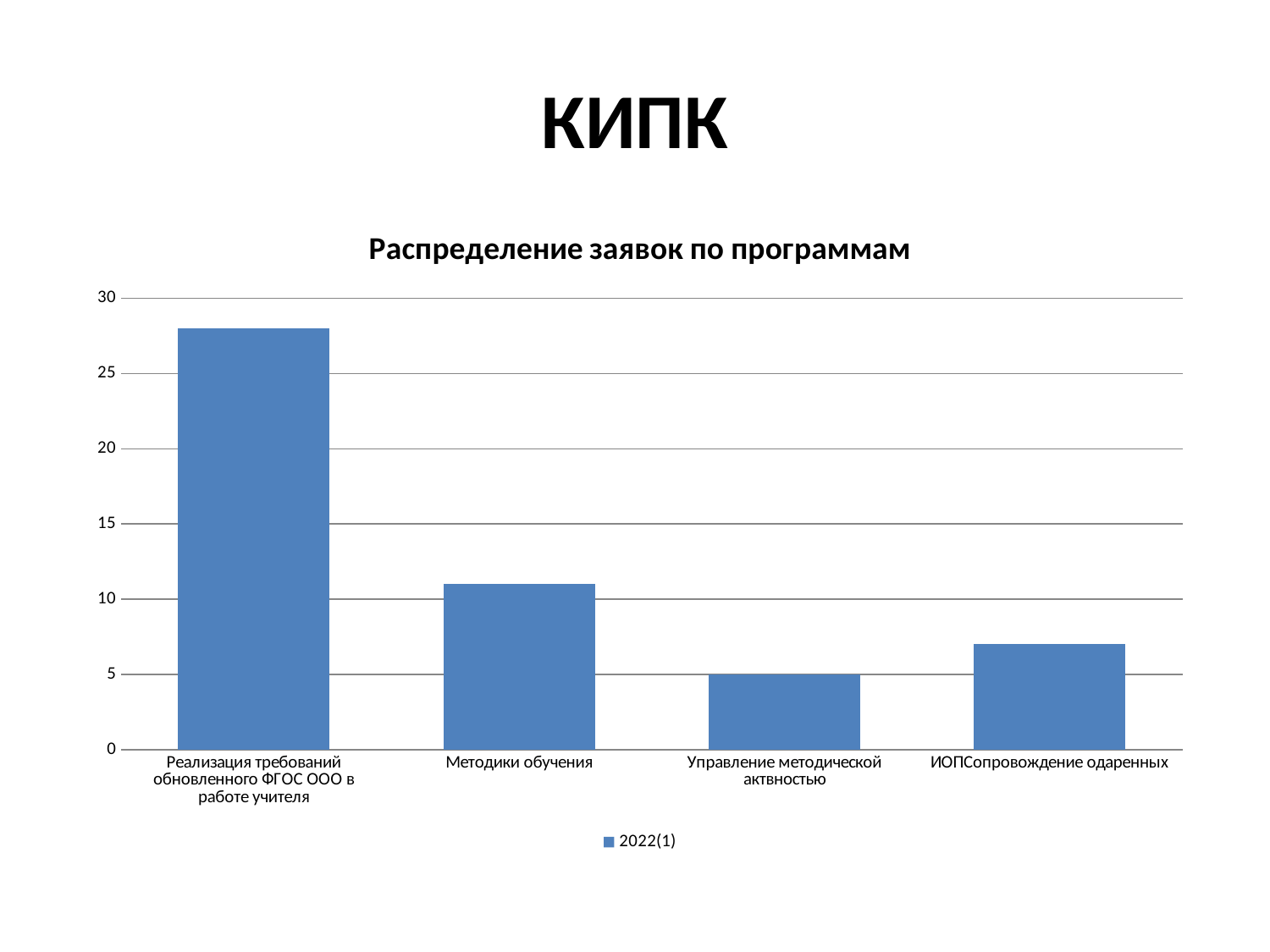
How many categories are shown on the x axis of the chart? 4 Is the value for ИОПСопровождение одаренных greater or less than 10? less What series name is shown in the legend? 2022(1) How many series does the legend list? 1 What is the title of the chart? Распределение заявок по программам Is the value for Методики обучения greater or less than 10? greater Which category has the highest value? Реализация требований обновленного ФГОС ООО в работе учителя Which category has the lowest value? Управление методической актвностью What is the value for Управление методической актвностью? 5 Is the value for Реализация требований обновленного ФГОС ООО в работе учителя greater or less than 25? greater What kind of chart is shown on the slide? bar chart Which is larger, the value for Методики обучения or the value for ИОПСопровождение одаренных? Методики обучения